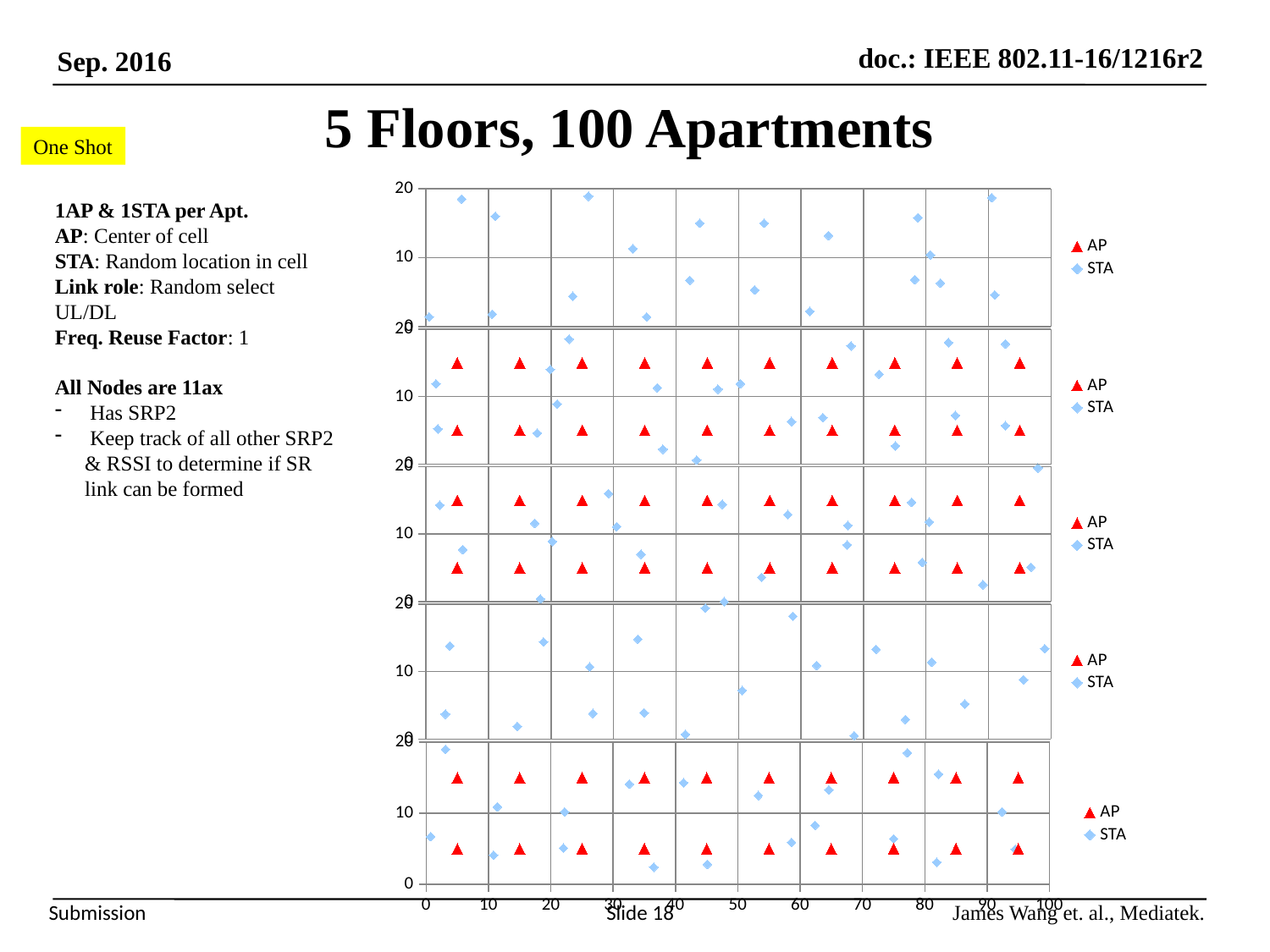
What is the title of the slide containing the charts? 5 Floors, 100 Apartments How many AP points (red triangles) are plotted in the bottom chart? 20 In the bottom chart, is the upper row of AP points greater or less than 10 on the y axis? greater How many series does the legend of the top chart list? 2 How many separate charts are shown on the slide? 5 How many AP points (red triangles) are plotted in the second chart from the top? 20 What kind of chart is used for each of the five floor plots on the slide? scatter chart In the middle (third) chart, is the lower row of AP points greater or less than 10 on the y axis? less What are the two series named in the legend of the bottom chart? AP and STA In the legend of the second chart from the top, which series is shown with red triangle markers? AP What is the highest value shown on the x axis of the bottom chart? 100 What is the highest value shown on the y axis of the bottom chart? 20